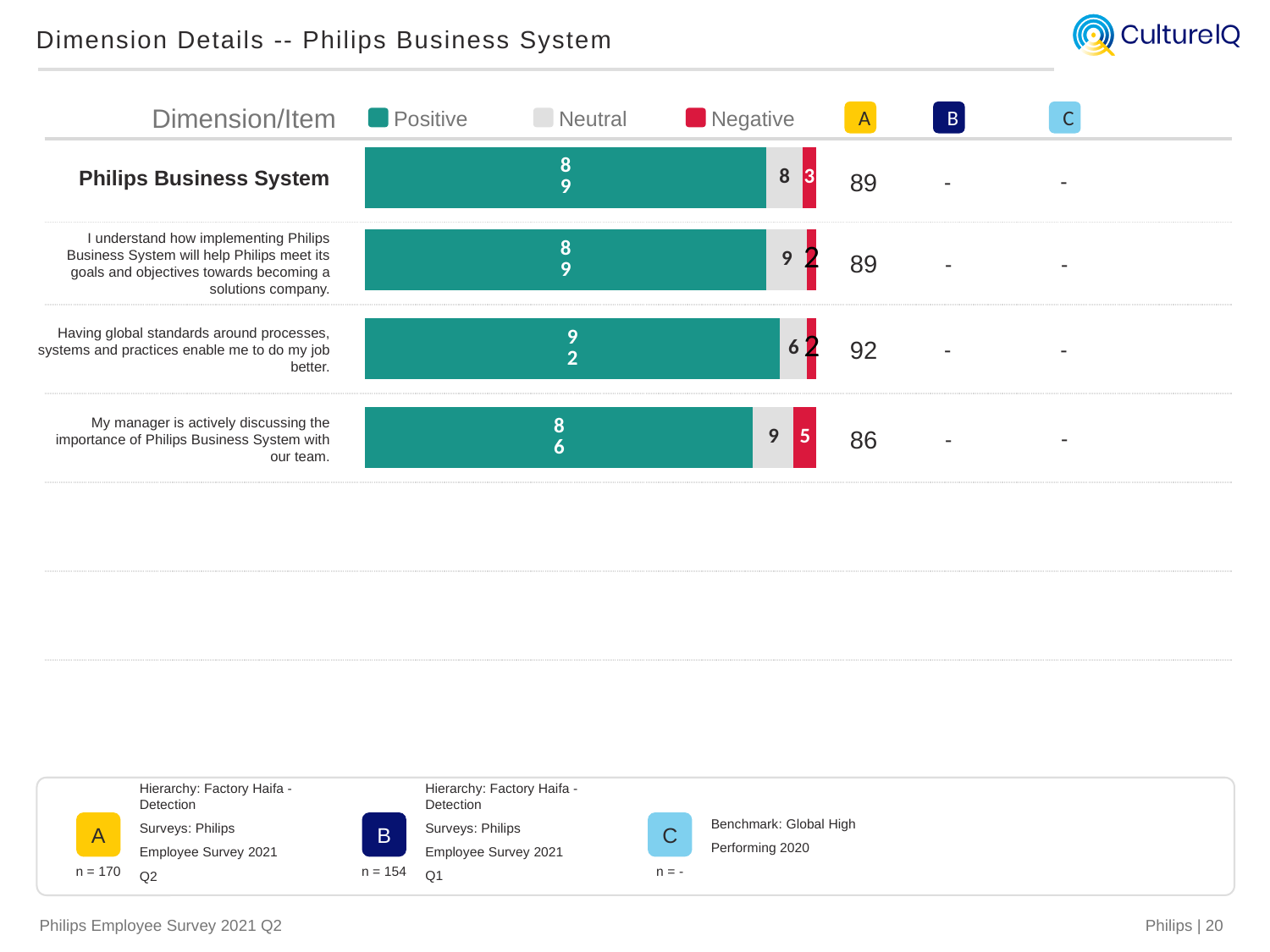
What kind of chart is used to show the Positive, Neutral and Negative values? Stacked bar chart Which item has the highest Positive value? Having global standards around processes, systems and practices enable me to do my job better. What is the total of the Positive, Neutral and Negative values for the "Philips Business System" bar? 100 How many item rows (bars) are shown in the chart? 4 What is the difference between the Positive values for "Having global standards around processes, systems and practices enable me to do my job better." and "My manager is actively discussing the importance of Philips Business System with our team."? 6 Which item has the lowest Positive value? My manager is actively discussing the importance of Philips Business System with our team. Which is larger: the Negative value for "My manager is actively discussing the importance of Philips Business System with our team." or the Negative value for "Philips Business System"? My manager is actively discussing the importance of Philips Business System with our team. How many series does the legend list? 3 What is the Neutral value for the "Philips Business System" dimension row? 8 What colour represents the Negative series in the legend? Red What is the Negative value for the item "My manager is actively discussing the importance of Philips Business System with our team."? 5 What is the Positive value for the item "Having global standards around processes, systems and practices enable me to do my job better."? 92